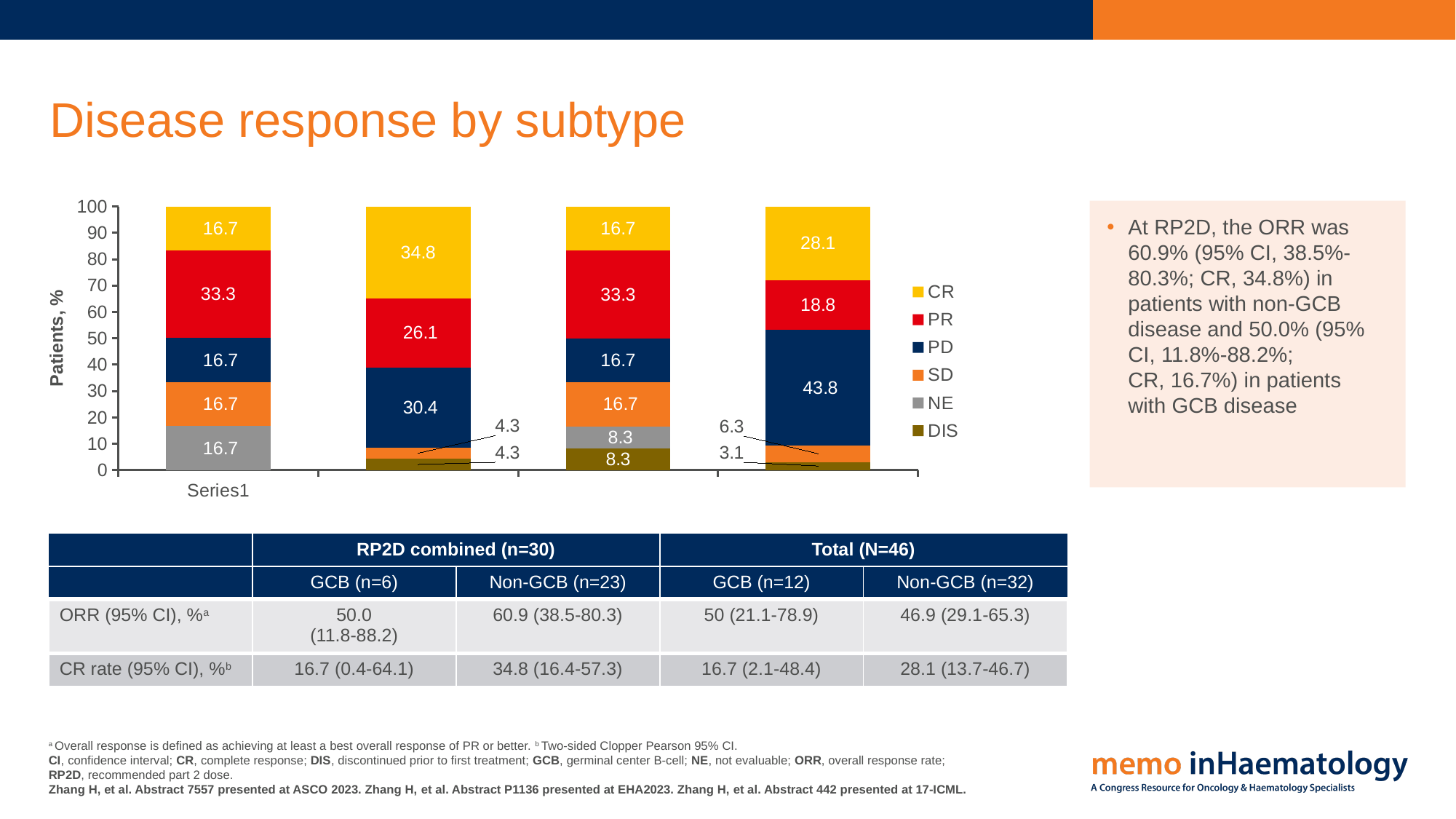
Which bar has the highest CR value? The second bar from the left What is the PD value in the fourth bar from the left? 43.8 What type of chart is shown on the slide? Stacked bar chart What is the difference between the PR value in the first bar and the PR value in the fourth bar? 14.5 How many stacked bars are plotted in the chart? 4 What is the title of the y-axis of the chart? Patients, % How many series does the chart legend list? 6 Which is larger: the PD value in the second bar or the PD value in the fourth bar? The fourth bar What is the difference between the CR value in the second bar and the CR value in the first bar? 18.1 What is the NE value in the third bar from the left? 8.3 What is the CR value in the second bar from the left? 34.8 What category label appears under the first bar on the x-axis? Series1